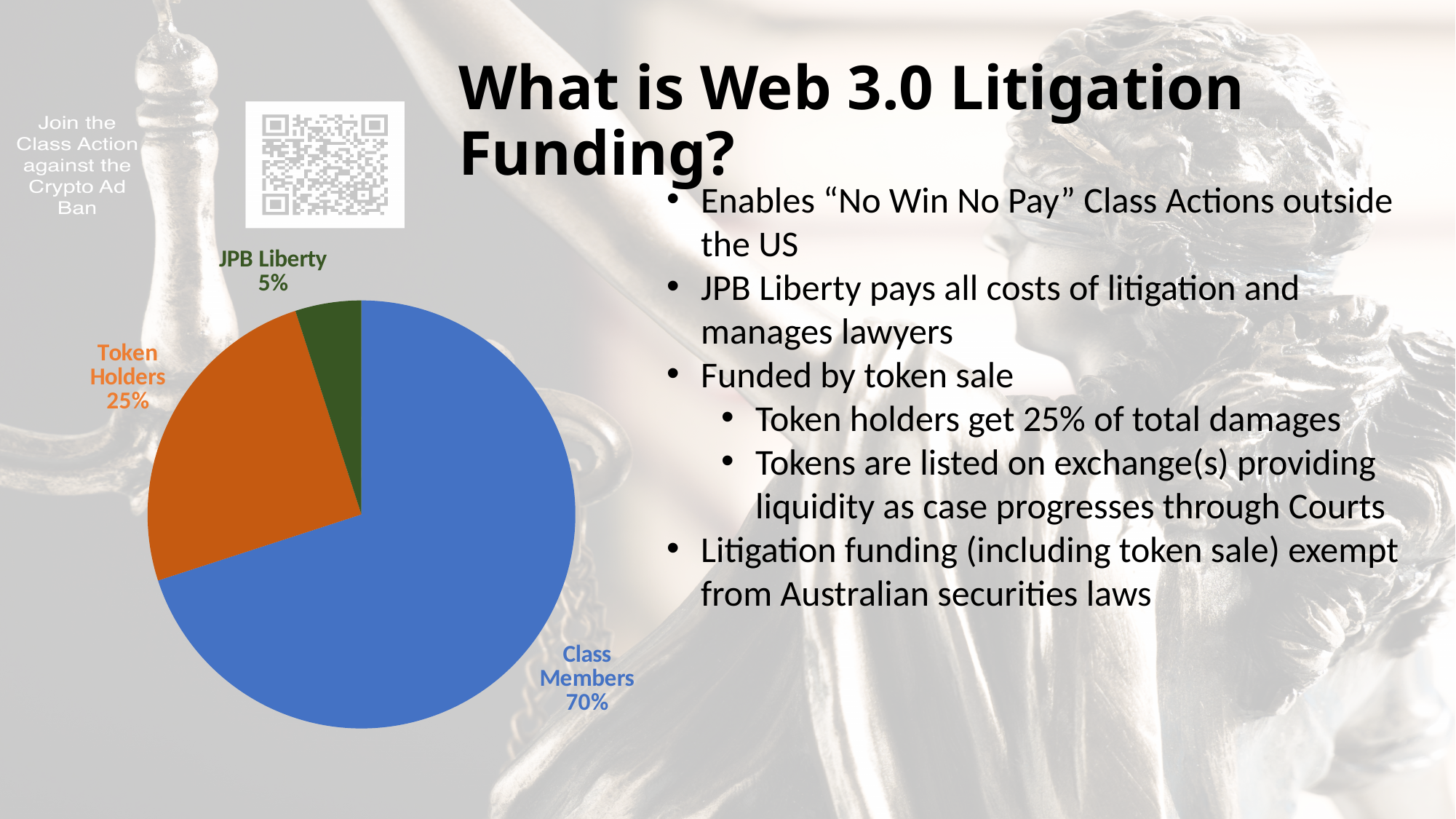
What share of the pie does Token Holders hold? 25% What colour is the JPB Liberty slice of the pie chart? green What colour is the Class Members slice of the pie chart? blue Which slice of the pie chart is the largest? Class Members How many slices does the pie chart have? 3 What is the difference in percentage points between the Token Holders slice and the JPB Liberty slice? 20 What is the difference in percentage points between the Class Members slice and the Token Holders slice? 45 Which slice of the pie chart is the smallest? JPB Liberty Which is larger, the Token Holders slice or the JPB Liberty slice? Token Holders What share of the pie does JPB Liberty hold? 5% What kind of chart is shown on the slide? pie chart What share of the pie does Class Members hold? 70%